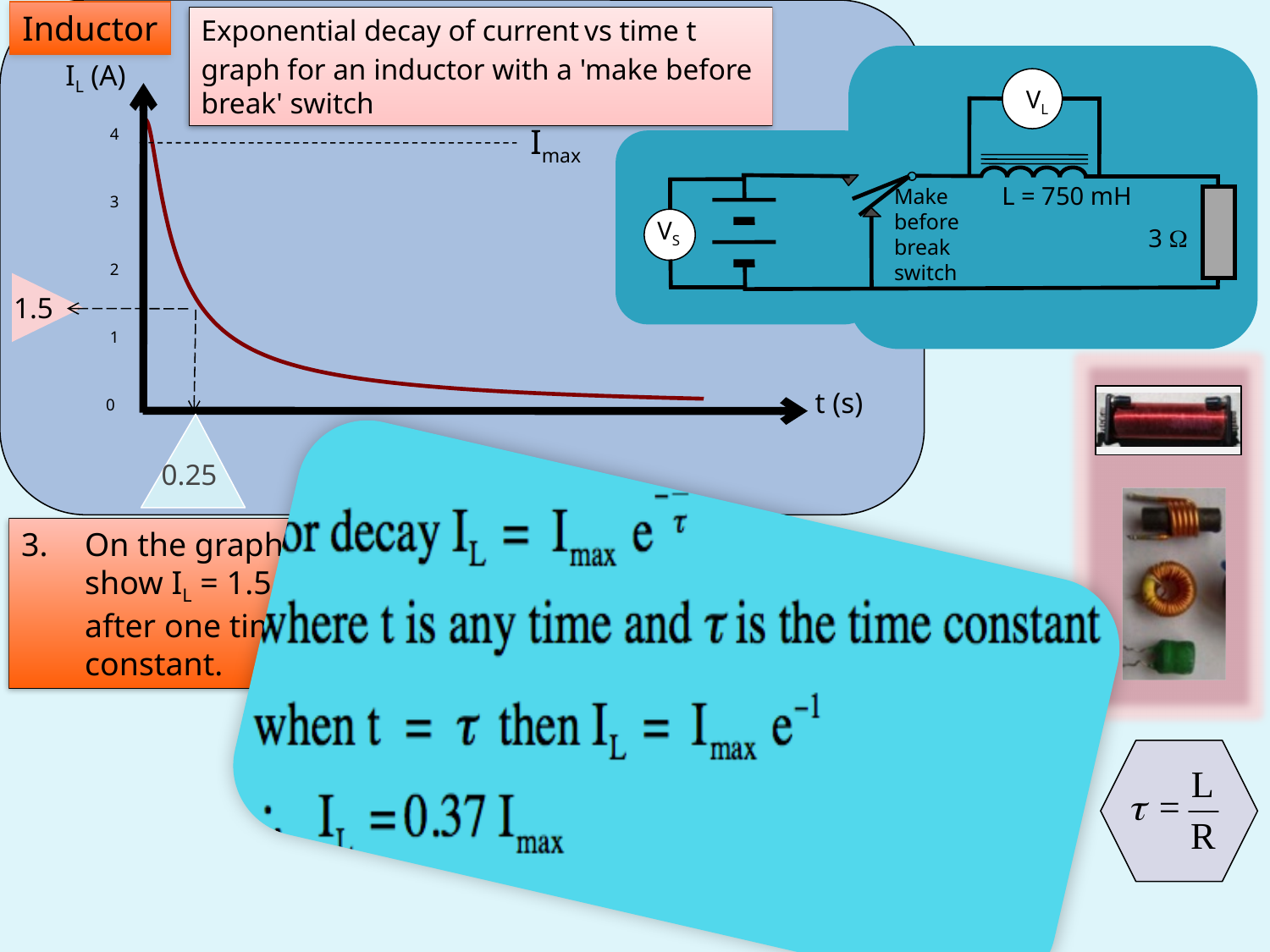
What is the label of the horizontal axis of the graph? t (s) What current value is marked on the graph at t = 0.25 s? 1.5 What is the value of I_max marked by the dashed line on the graph? 4 Is I_max greater or less than 3 A? greater What is the difference between I_max and the current marked at t = 0.25 s? 2.5 How many numbered tick marks are shown on the vertical axis of the graph? 5 Does the current I_L rise or fall as time t increases along the x axis? fall How many curves are plotted on the graph? 1 What is the label of the vertical axis of the graph? I_L (A) At what time t does the graph mark the current I_L = 1.5 A? 0.25 Is the current at t = 0.25 s greater or less than 2 A? less What kind of chart is shown on the slide? line chart